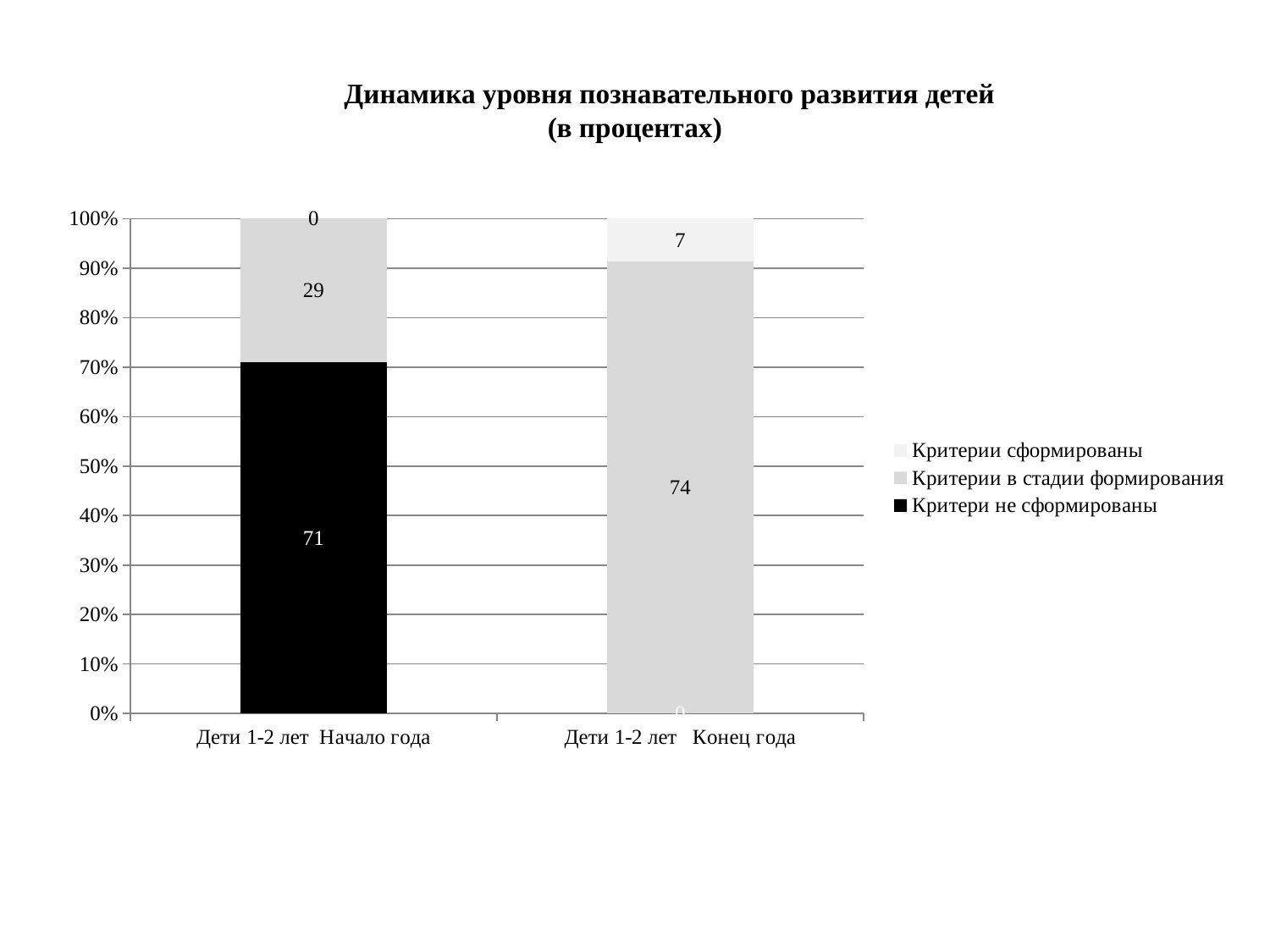
Which is larger: "Критери не сформированы" for "Дети 1-2 лет Начало года" or "Критерии в стадии формирования" for "Дети 1-2 лет Начало года"? Критери не сформированы What is the value for "Критери не сформированы" for "Дети 1-2 лет Начало года"? 71 What is the value for "Критерии сформированы" for "Дети 1-2 лет Начало года"? 0 What is the value for "Критерии в стадии формирования" for "Дети 1-2 лет Начало года"? 29 What is the title of the chart? Динамика уровня познавательного развития детей (в процентах) How many series does the legend list? 3 How many categories are shown on the x axis? 2 What is the total of the data labels in the "Дети 1-2 лет Начало года" bar? 100 What is the difference between the "Критерии в стадии формирования" values for "Дети 1-2 лет Конец года" and "Дети 1-2 лет Начало года"? 45 What is the value for "Критерии сформированы" for "Дети 1-2 лет Конец года"? 7 What is the value for "Критерии в стадии формирования" for "Дети 1-2 лет Конец года"? 74 What kind of chart is shown on the slide? Stacked bar chart